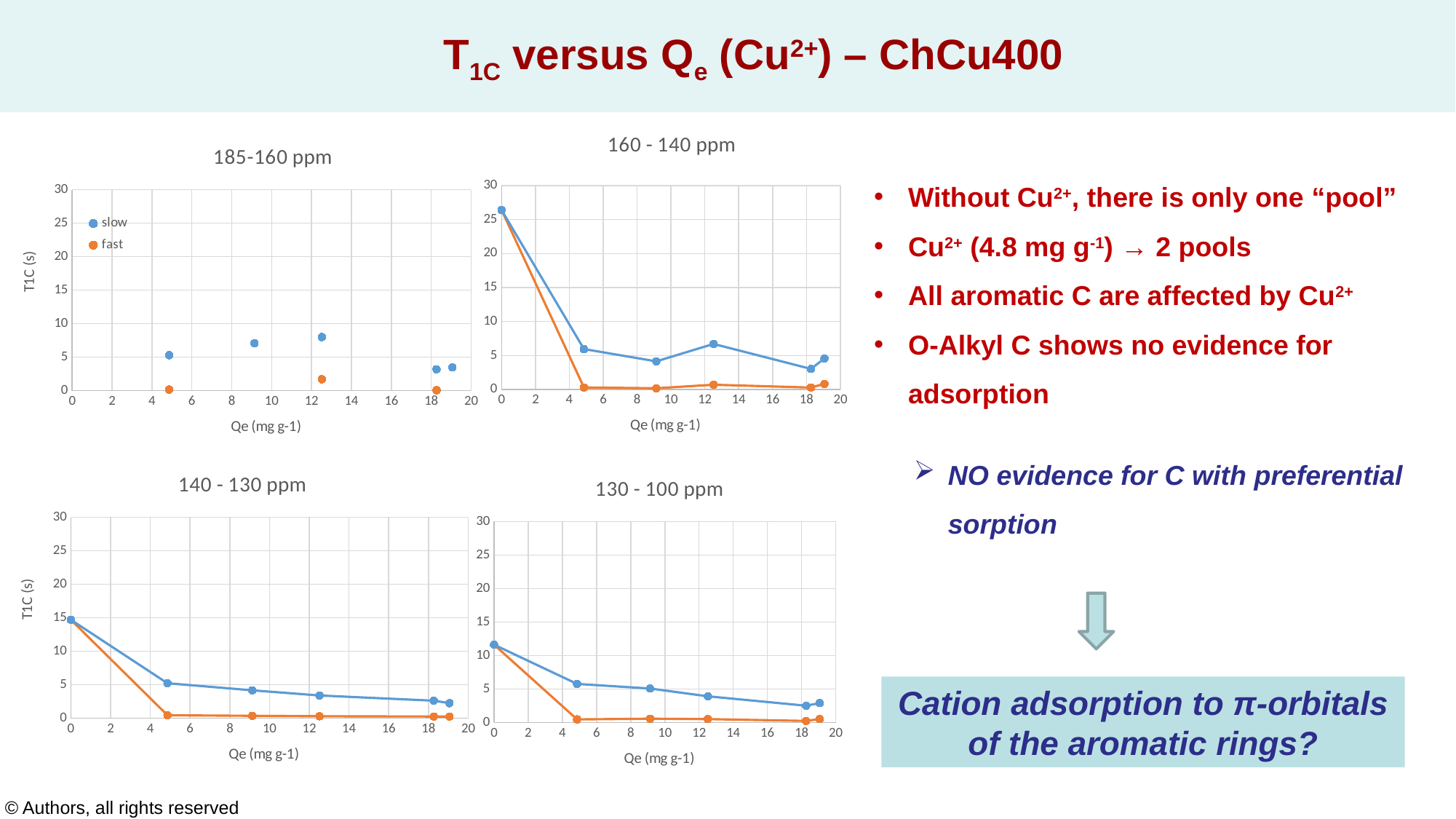
How many charts are shown on the slide? 4 In the "140 - 130 ppm" chart, at which Qe value does the slow series reach its highest T1C? 0 In the "185-160 ppm" chart, what are the two legend entries? slow and fast In the "185-160 ppm" chart, how many series does the legend list? 2 In the "140 - 130 ppm" chart, does the slow series rise or fall as Qe increases? fall In the "160 - 140 ppm" chart, is the fast series value at Qe of about 5 greater or less than 5? less In the "185-160 ppm" chart, at Qe of about 12.5, which series has the larger value, slow or fast? slow In the "130 - 100 ppm" chart, is the slow series value at Qe = 0 greater or less than 10? greater In the "185-160 ppm" chart, how many points are plotted for the slow series? 5 What kind of chart is the "160 - 140 ppm" chart? line chart In the "160 - 140 ppm" chart, is the slow series value at Qe = 0 greater or less than 25? greater What is the x-axis label of the "160 - 140 ppm" chart? Qe (mg g-1)